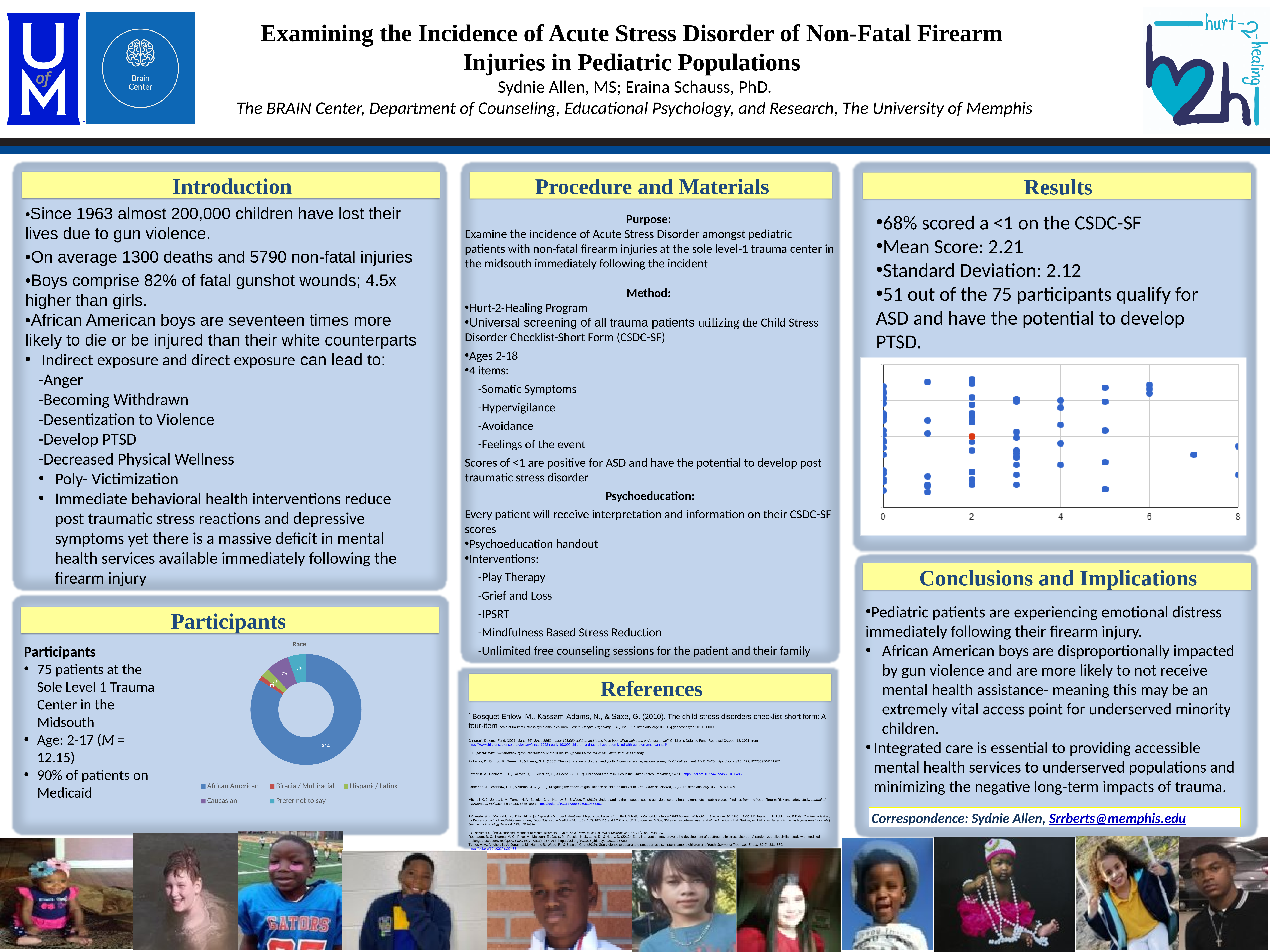
On the Race chart, how many categories does the legend list? 5 On the Race chart, what share of participants is Caucasian? 7% On the Race chart, what is the difference in percentage points between the Caucasian and Hispanic/Latinx shares? 4 What kind of chart is the Race chart in the Participants section? Donut (pie) chart On the Race chart, what share of participants is African American? 84% On the Race chart, which category has the smallest share? Biracial/ Multiracial On the Race chart, what share of participants is Hispanic/Latinx? 3% On the Race chart, which category has the largest share? African American On the Race chart, what share of participants chose Prefer not to say? 5% On the Race chart, what share of participants is Biracial/Multiracial? 1% What kind of chart is shown in the Results section? Scatter plot On the Race chart, which share is larger, Caucasian or Prefer not to say? Caucasian